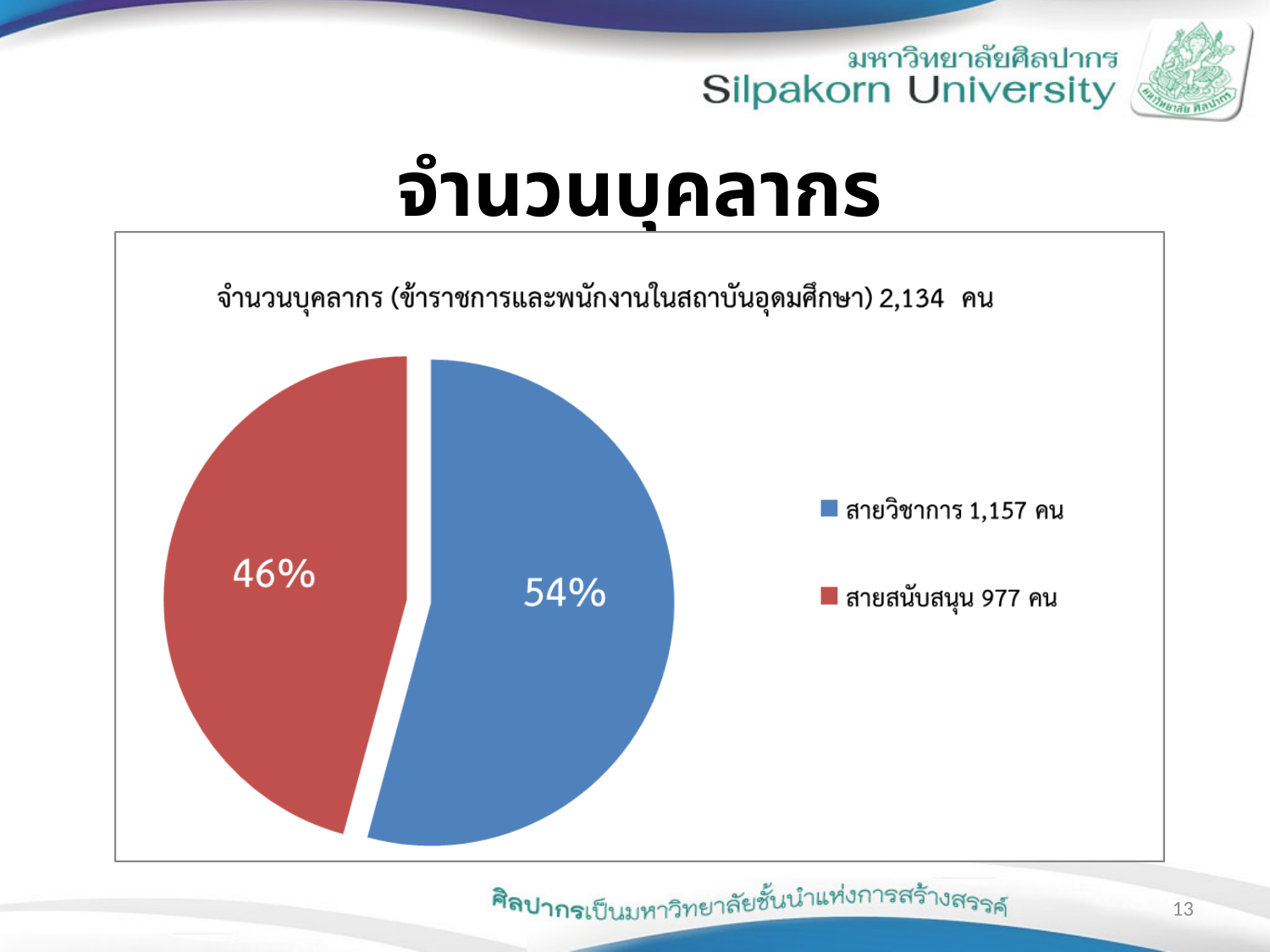
What kind of chart is shown on the slide? Pie chart Which category has the largest slice of the pie? สายวิชาการ What colour is the slice for สายสนับสนุน? Red How many entries does the legend of the pie chart list? 2 How many slices does the pie chart have? 2 What share of the pie does สายวิชาการ represent? 54% Which category has the smallest slice of the pie? สายสนับสนุน How many people are in สายวิชาการ according to the legend? 1,157 คน What share of the pie does สายสนับสนุน represent? 46% How many people are in สายสนับสนุน according to the legend? 977 คน What is the difference in headcount between สายวิชาการ and สายสนับสนุน? 180 คน Which is larger, สายวิชาการ or สายสนับสนุน? สายวิชาการ